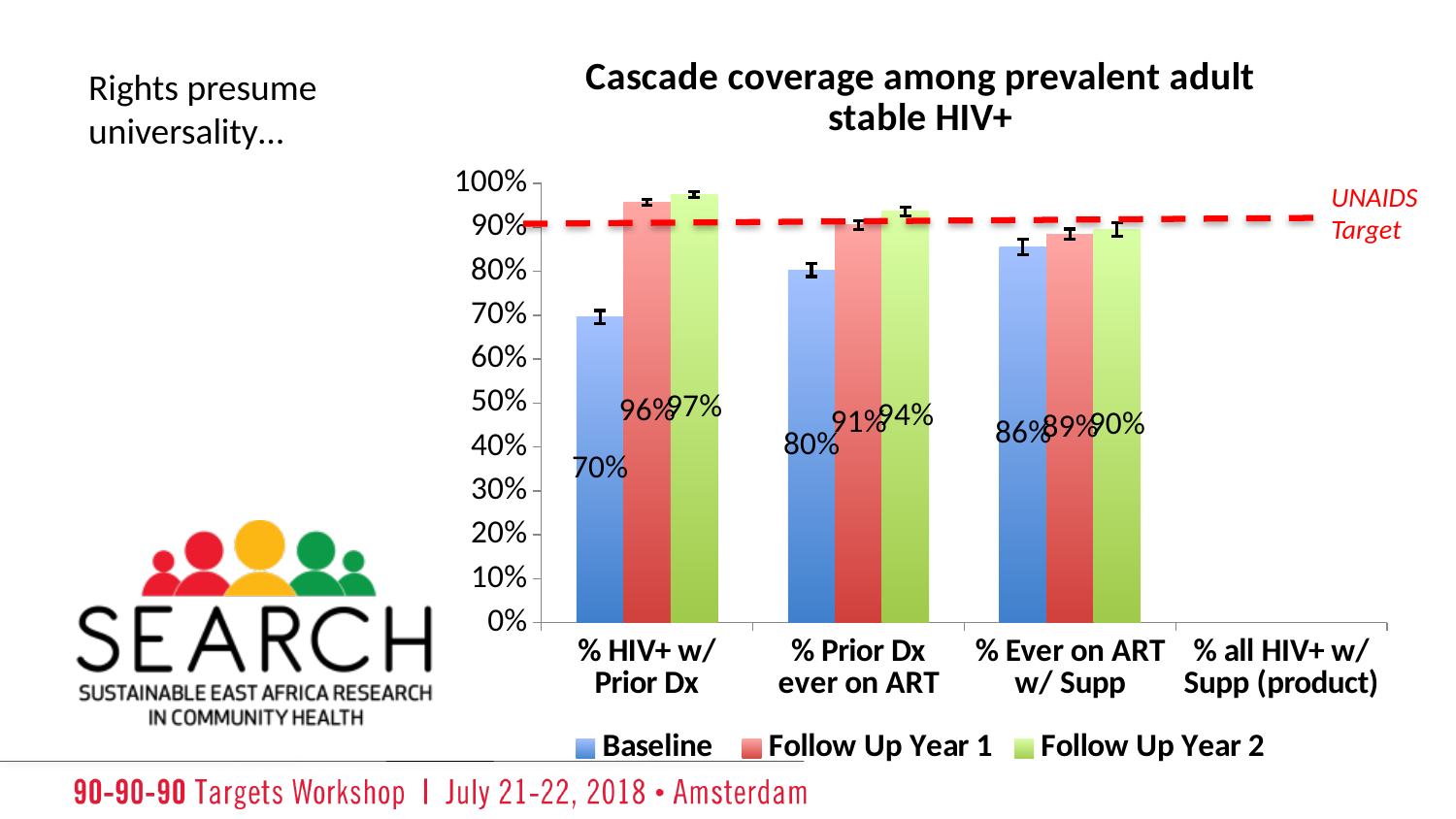
Is the Follow Up Year 1 value for % Ever on ART w/ Supp greater or less than 90%? less Which is larger: the Baseline value for % Ever on ART w/ Supp or the Baseline value for % Prior Dx ever on ART? % Ever on ART w/ Supp What does the red dashed line on the chart represent? UNAIDS Target What is the Follow Up Year 1 value for % Ever on ART w/ Supp? 89% What kind of chart is shown on the slide? Bar chart How many series does the legend list? 3 Which category has the highest Follow Up Year 2 value? % HIV+ w/ Prior Dx Which category has the lowest Baseline value? % HIV+ w/ Prior Dx What is the Baseline value for % HIV+ w/ Prior Dx? 70% What is the difference between the Follow Up Year 1 and Baseline values for % Prior Dx ever on ART? 11% What is the Follow Up Year 2 value for % Prior Dx ever on ART? 94% What is the difference between the Follow Up Year 2 and Baseline values for % HIV+ w/ Prior Dx? 27%